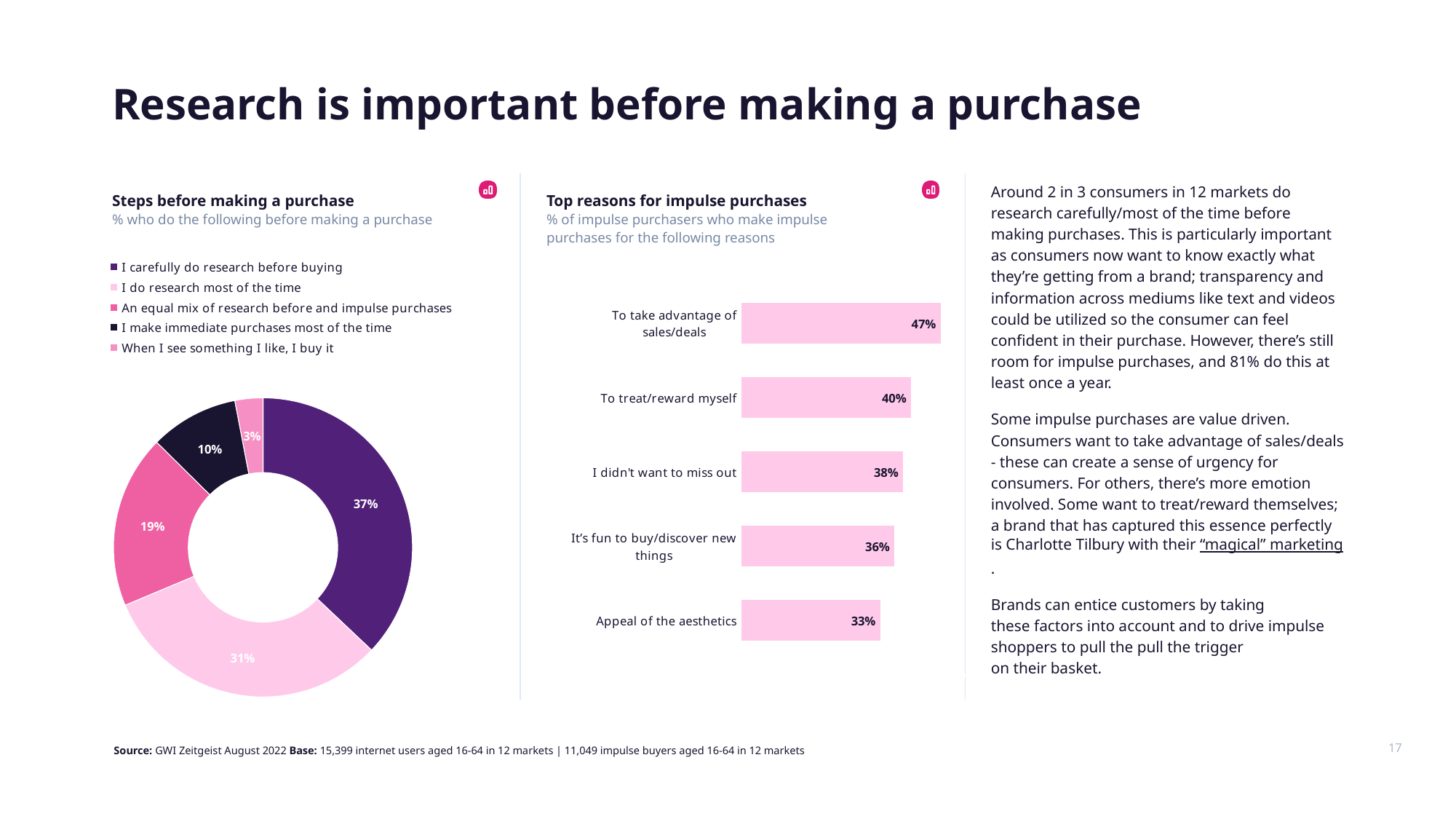
In the 'Top reasons for impulse purchases' chart, which reason has the highest value? To take advantage of sales/deals In the 'Steps before making a purchase' chart, what is the difference between 'An equal mix of research before and impulse purchases' and 'I make immediate purchases most of the time'? 9% In the 'Top reasons for impulse purchases' chart, what is the value for 'To treat/reward myself'? 40% In the 'Top reasons for impulse purchases' chart, what is the difference between 'To take advantage of sales/deals' and 'Appeal of the aesthetics'? 14% In the 'Steps before making a purchase' chart, what percentage carefully do research before buying? 37% In the 'Steps before making a purchase' chart, which category has the smallest share? When I see something I like, I buy it In the 'Top reasons for impulse purchases' chart, which is larger: 'I didn't want to miss out' or 'It's fun to buy/discover new things'? I didn't want to miss out What kind of chart is 'Top reasons for impulse purchases'? Bar chart In the 'Top reasons for impulse purchases' chart, which reason has the lowest value? Appeal of the aesthetics In the 'Steps before making a purchase' chart, how many categories does the legend list? 5 What kind of chart is 'Steps before making a purchase'? Doughnut chart In the 'Steps before making a purchase' chart, what percentage do research most of the time? 31%